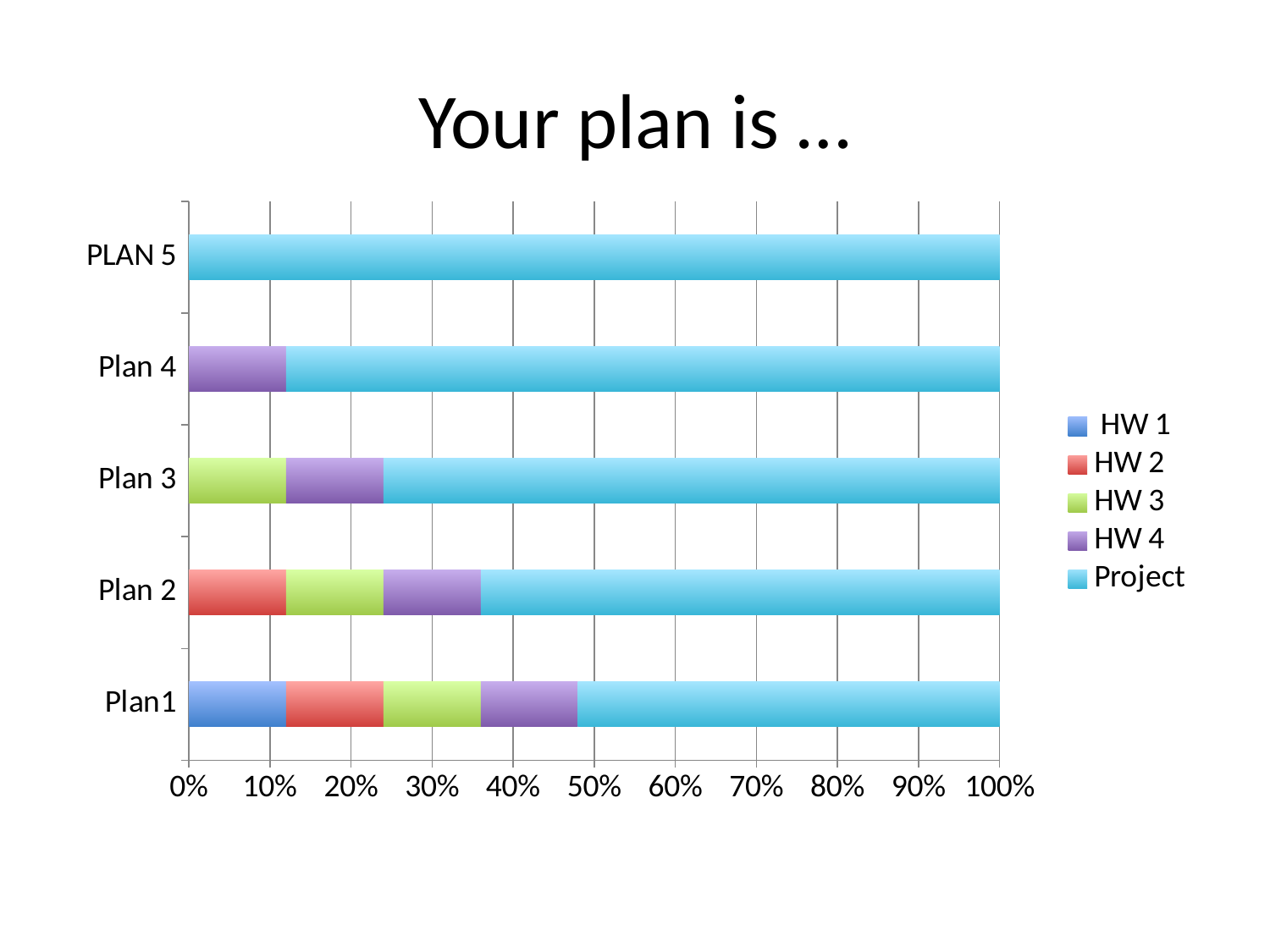
Is the Project share for Plan 2 greater or less than 60%? greater Which plan has the largest Project share? PLAN 5 Which series is shown in green in the legend? HW 3 What is the Project share for PLAN 5? 100% Is the HW 4 share for Plan 4 greater or less than 20%? less Which plan has the smallest Project share? Plan1 How many plans (categories) are shown on the chart? 5 Is the Project share for Plan 3 greater or less than 70%? greater What is the title of the chart's slide? Your plan is … How many series does the legend list? 5 What kind of chart is shown on the slide? bar chart Which plan has a larger Project share, Plan 4 or Plan 2? Plan 4